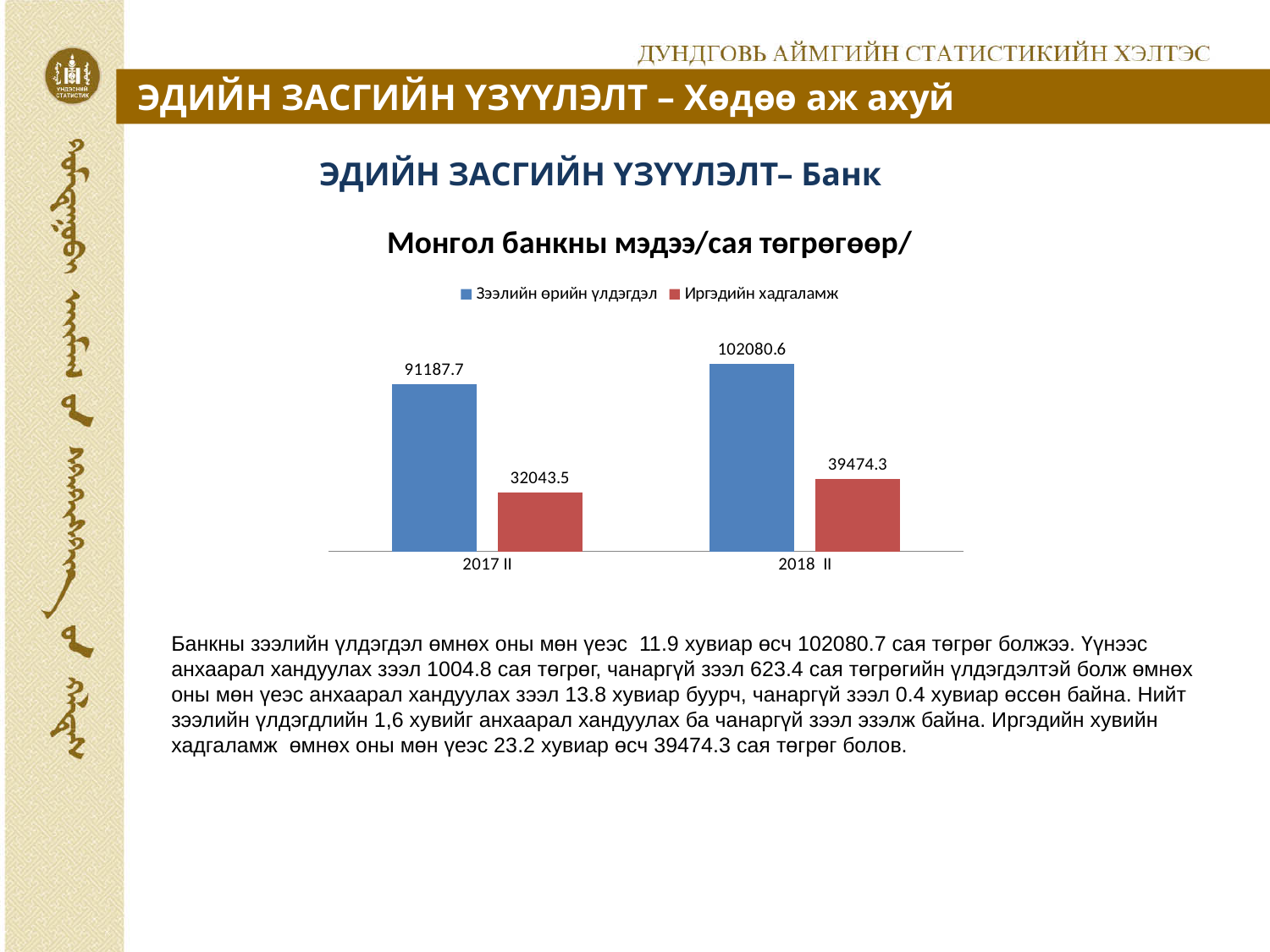
Does the value of Иргэдийн хадгаламж rise or fall from 2017 II to 2018 II? rise What is the difference between the Зээлийн өрийн үлдэгдэл values for 2018 II and 2017 II? 10892.9 How many categories are shown on the x axis of the chart? 2 How many series does the chart legend list? 2 What is the value of Зээлийн өрийн үлдэгдэл for 2017 II? 91187.7 Which is larger in 2018 II: Зээлийн өрийн үлдэгдэл or Иргэдийн хадгаламж? Зээлийн өрийн үлдэгдэл What is the value of Иргэдийн хадгаламж for 2018 II? 39474.3 What is the title of the chart? Монгол банкны мэдээ/сая төгрөгөөр/ What is the value of Иргэдийн хадгаламж for 2017 II? 32043.5 Which category has the lowest value for Иргэдийн хадгаламж? 2017 II Which category has the highest value for Зээлийн өрийн үлдэгдэл? 2018 II What type of chart is shown on the slide? bar chart